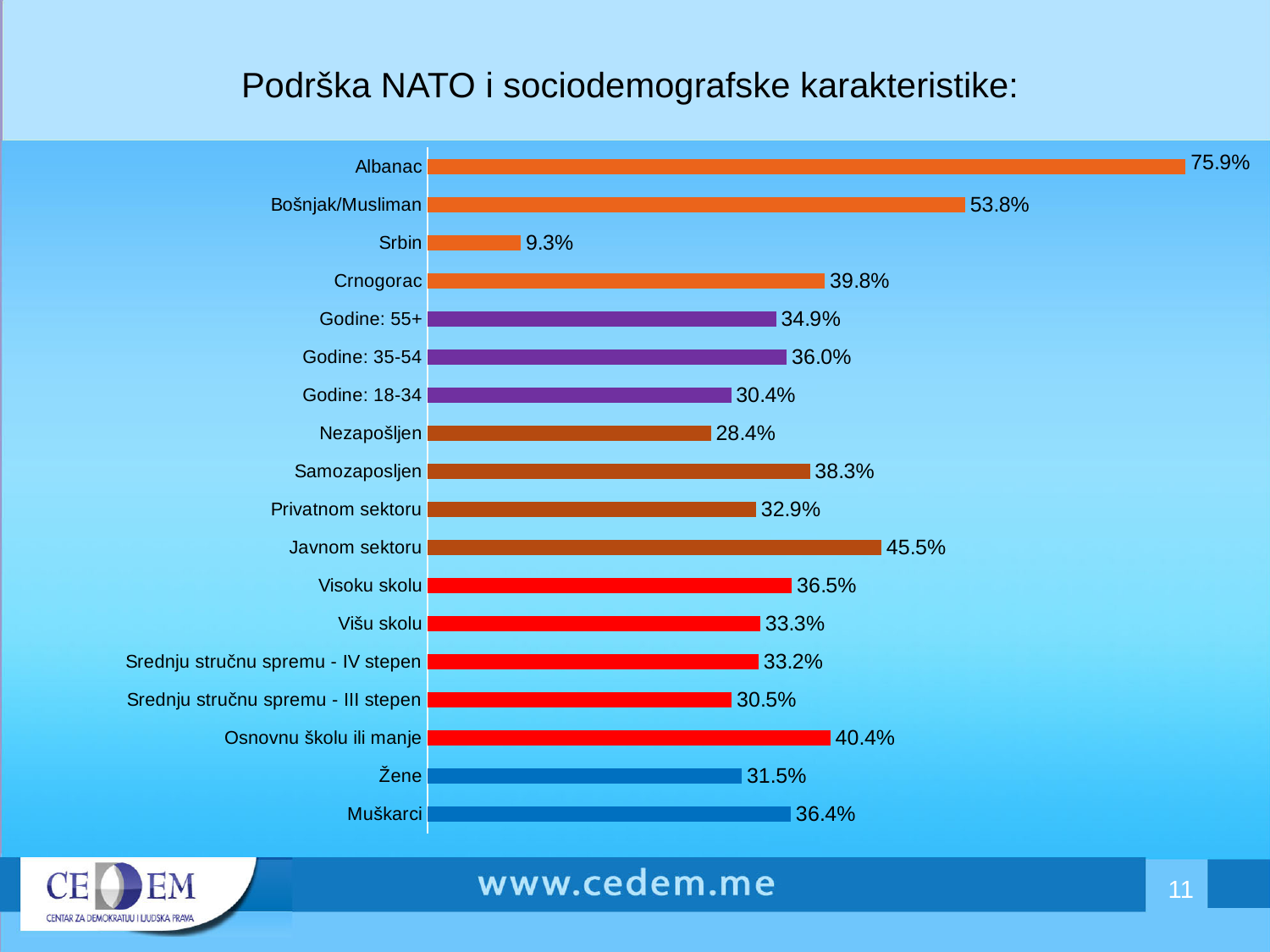
What is the value for Osnovnu školu ili manje? 40.4% Which is larger, the value for Godine: 35-54 or the value for Godine: 18-34? Godine: 35-54 What is the difference between the values for Javnom sektoru and Privatnom sektoru? 12.6 percentage points Which category has the highest value? Albanac Which category has the lowest value? Srbin What kind of chart is shown on the slide? Bar chart What is the value for Godine: 18-34? 30.4% What is the difference between the values for Muškarci and Žene? 4.9 percentage points What is the value for Javnom sektoru? 45.5% How many categories are shown in the chart? 18 What is the value for Albanac? 75.9% What is the title of the chart? Podrška NATO i sociodemografske karakteristike: